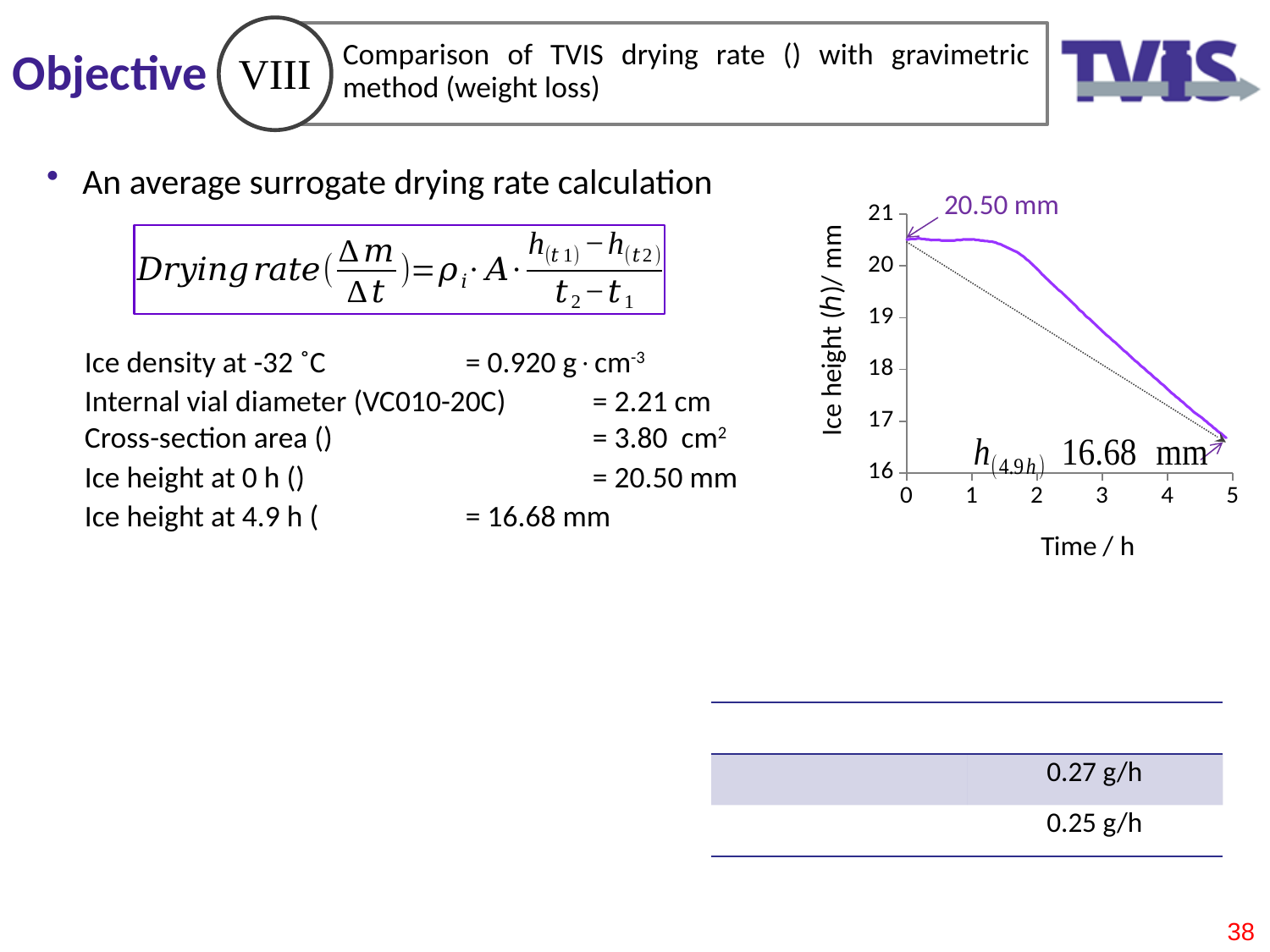
What is the highest value shown on the y axis of the chart? 21 Is the ice height at 1 h greater or less than 20? greater Does the ice height rise or fall as time increases along the x axis? fall Which is larger, the ice height at 0 h or at 4.9 h? 0 h What is the ice height at 4.9 h according to the chart label? 16.68 mm What kind of chart is shown on the slide? line chart What is the difference between the ice height at 0 h and at 4.9 h? 3.82 mm Is the ice height at 2 h greater or less than 19? greater What is the ice height at 0 h according to the chart label? 20.50 mm What is the label of the x axis of the chart? Time / h